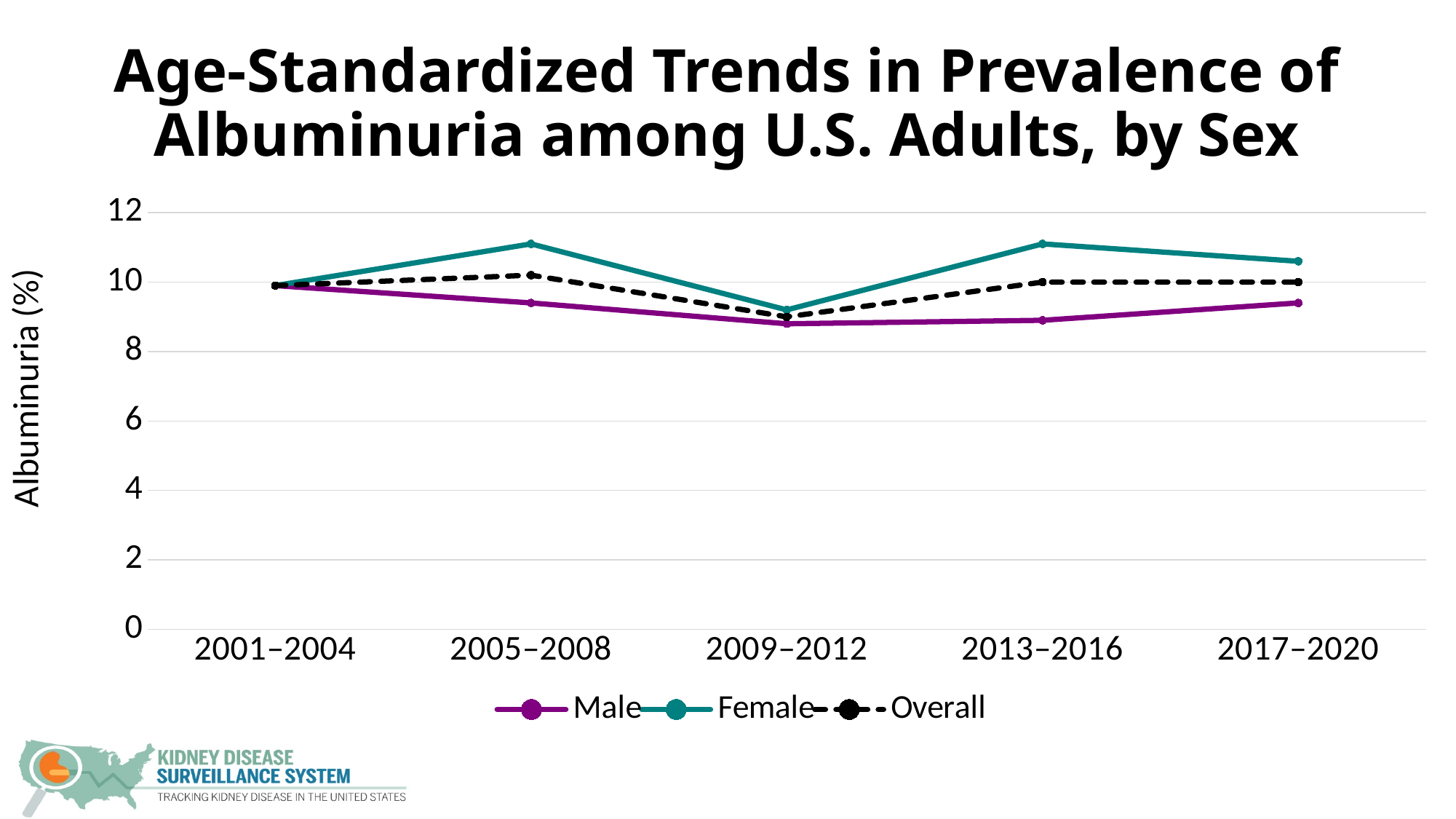
How many series does the legend list? 3 Is the Male value for 2009–2012 greater or less than 10? less What is the label on the y axis? Albuminuria (%) Which is larger in 2013–2016, the Male value or the Female value? Female Is the Female value for 2005–2008 greater or less than 10? greater In which period is the Female value lowest? 2009–2012 How many time periods are shown on the x axis? 5 Is the Overall value for 2009–2012 greater or less than 10? less What kind of chart is shown on the slide? line chart In which period is the Male value highest? 2001–2004 Does the Male line rise or fall from 2001–2004 to 2009–2012? fall